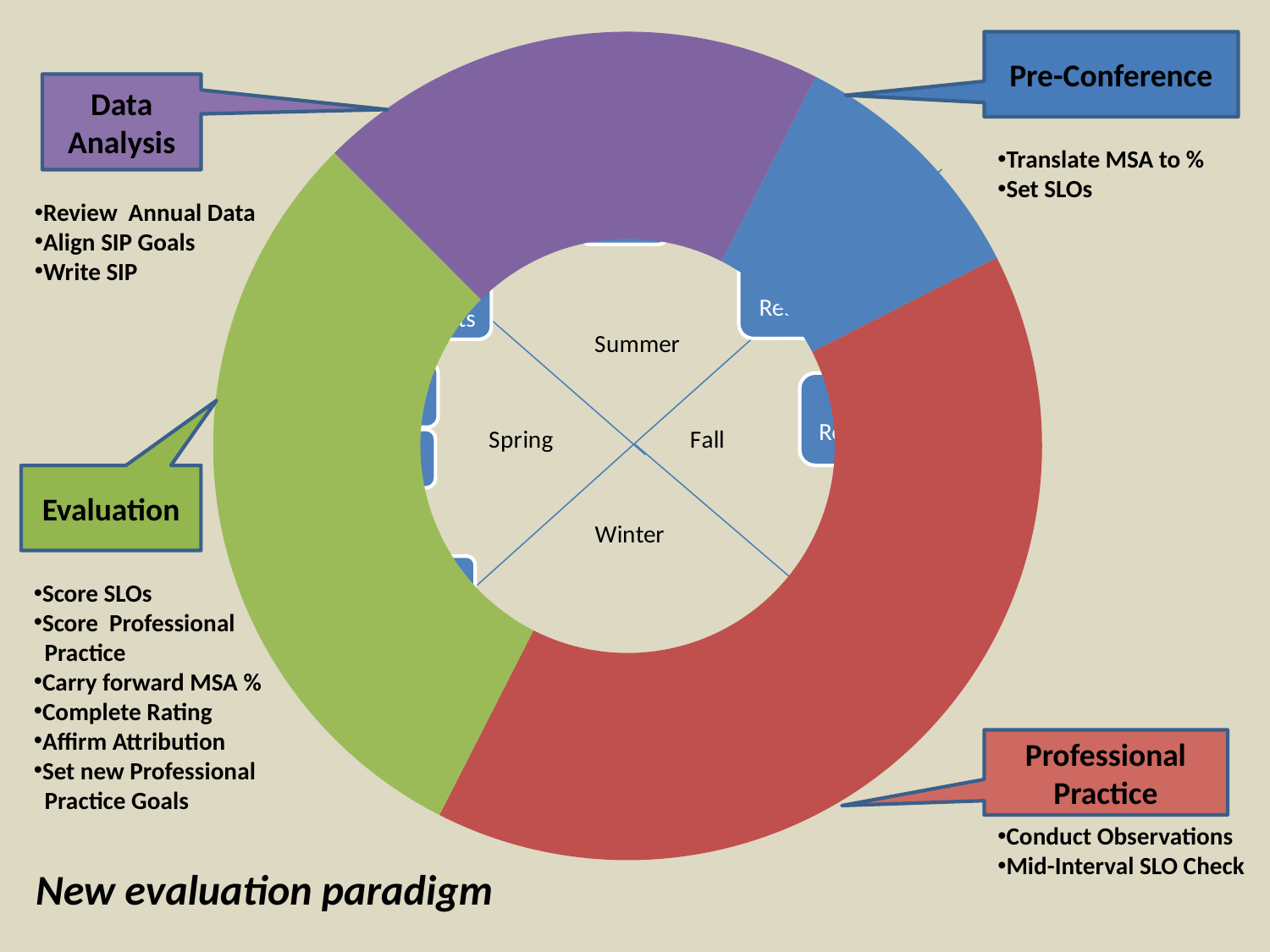
What kind of chart is shown on the slide? doughnut chart Which segment is smaller, Pre-Conference or Evaluation? Pre-Conference Which segment of the doughnut chart is the largest? Professional Practice Which segment is larger, Pre-Conference or Data Analysis? Data Analysis Which segment of the doughnut chart is the smallest? Pre-Conference How many segments does the doughnut chart have? 4 What colour is the Evaluation segment of the doughnut chart? green Which segment is larger, Professional Practice or Evaluation? Professional Practice Which segment of the doughnut chart is coloured purple? Data Analysis